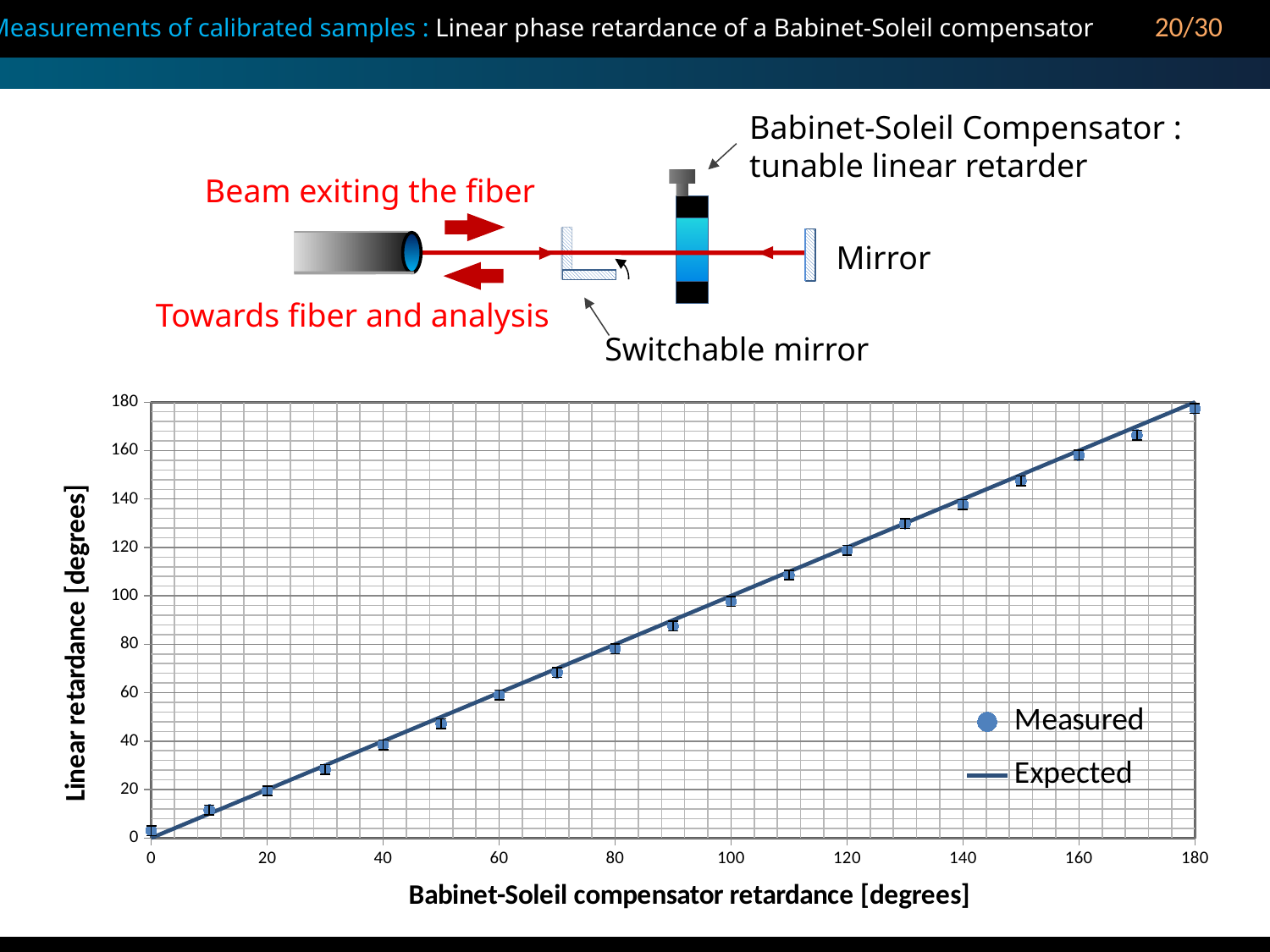
Do the Measured values rise or fall as the Babinet-Soleil compensator retardance increases along the x axis? rise Is the Measured value at a compensator retardance of 20 degrees greater or less than 40? less Is the Measured value at a compensator retardance of 80 degrees greater or less than 100? less How many series does the chart legend list? 2 How many Measured data points are plotted on the chart? 19 At which x-axis value is the Measured linear retardance highest? 180 What kind of chart is shown on the slide? scatter chart with a line What are the two series named in the chart legend? Measured and Expected What is the title of the x axis of the chart? Babinet-Soleil compensator retardance [degrees] Is the Measured value at a compensator retardance of 140 degrees greater or less than 120? greater Which is larger, the Measured value at a compensator retardance of 160 degrees or at 60 degrees? 160 degrees At which x-axis value is the Measured linear retardance lowest? 0